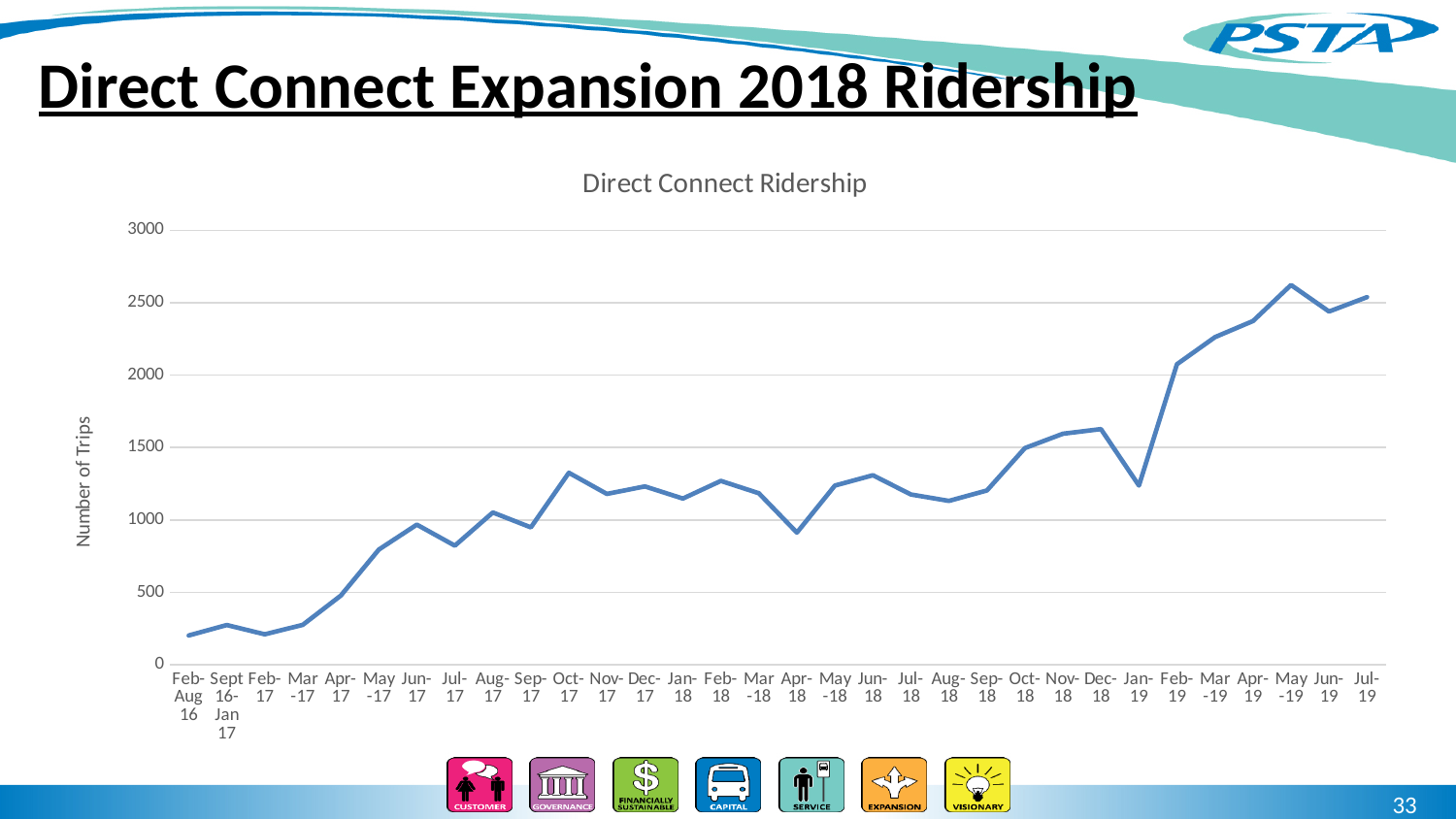
Is the value for Feb-19 greater or less than 2000? greater Which is larger, the value for Dec-18 or the value for Jan-19? Dec-18 Is the value for Mar-17 greater or less than 500? less Is the value for Apr-18 greater or less than 1000? less How many data points are plotted on the line? 32 Which period has the highest number of trips? May-19 What is the label on the vertical axis of the chart? Number of Trips What kind of chart is shown on the slide? Line chart Overall, do the number of trips rise or fall from Feb-Aug 16 to Jul-19? Rise What is the title of the chart? Direct Connect Ridership